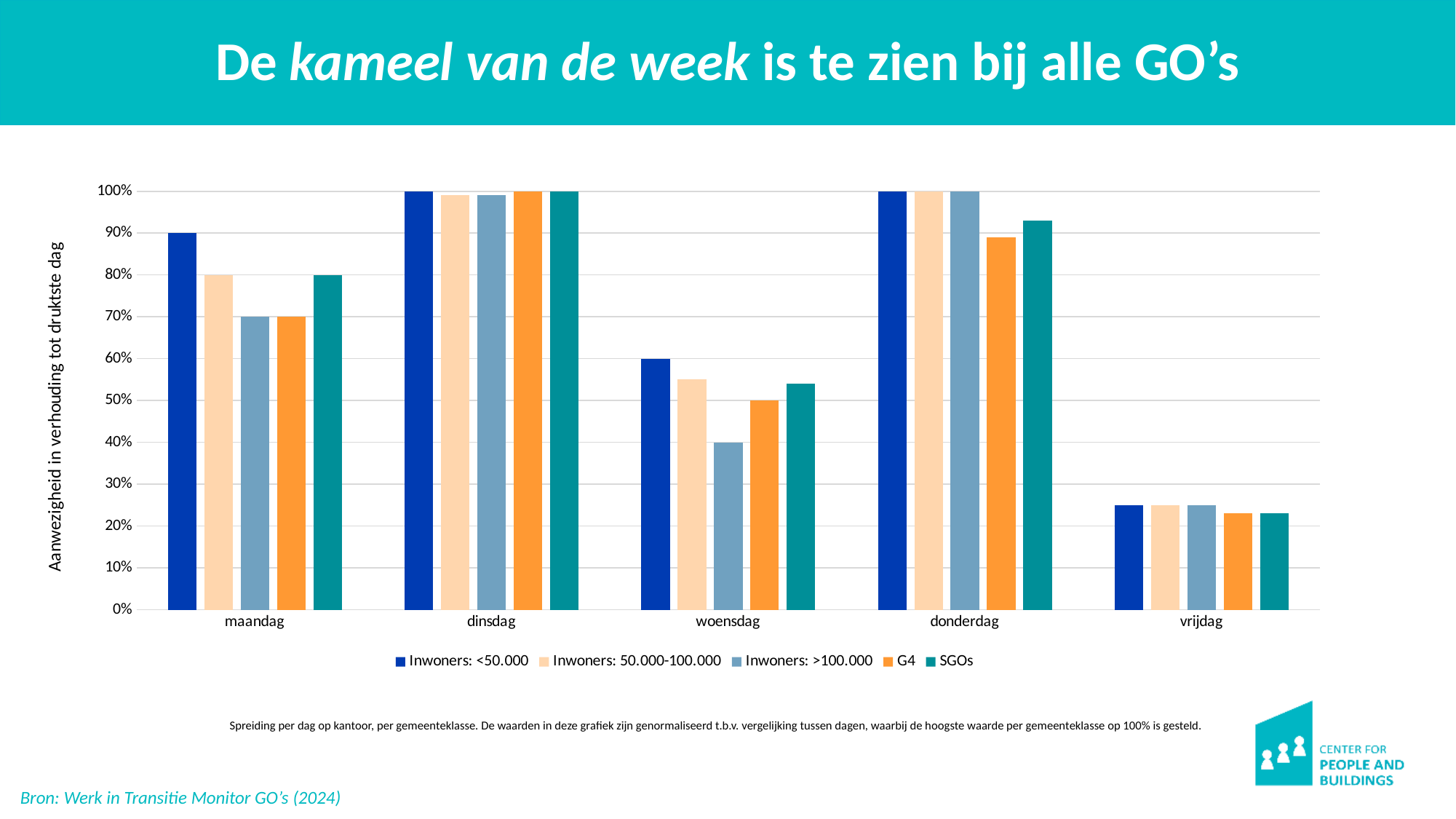
Is the value for G4 on donderdag greater or less than 80%? greater What is the value for Inwoners: >100.000 on woensdag? 40% How many days (categories) are shown on the x axis? 5 Which day has the lowest values across all series? vrijdag What is the value for G4 on dinsdag? 100% How many series does the legend list? 5 Is the value for SGOs on vrijdag greater or less than 30%? less What is the value for Inwoners: <50.000 on maandag? 90% What type of chart is shown on the slide? bar chart What is the difference between Inwoners: <50.000 and Inwoners: >100.000 on woensdag? 20% What is the value for SGOs on maandag? 80% On woensdag, which is larger: Inwoners: <50.000 or G4? Inwoners: <50.000